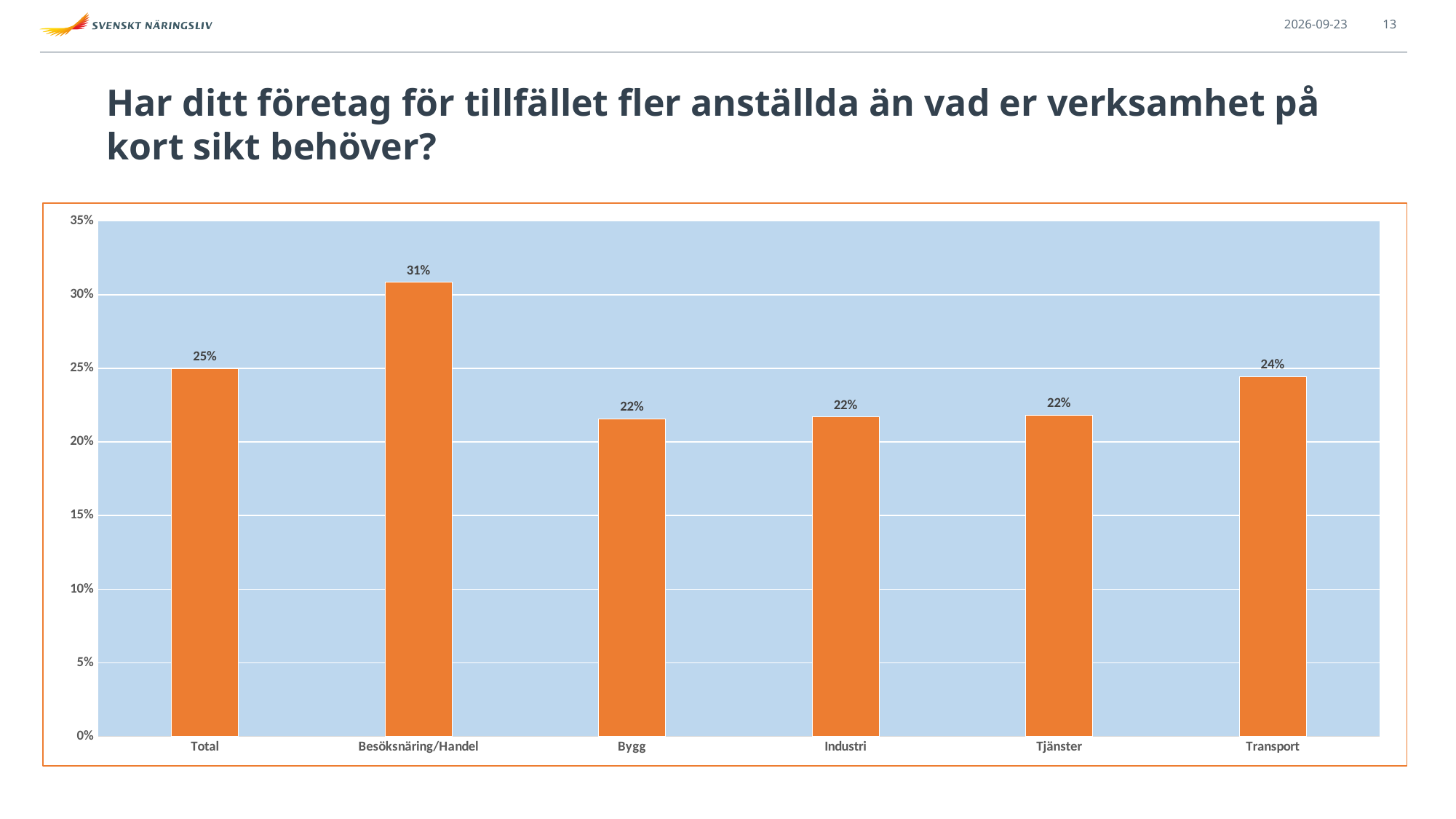
Is the value for Besöksnäring/Handel greater or less than 30%? greater What is the value for Industri? 22% Is the value for Bygg greater or less than 25%? less What is the difference between the values for Transport and Bygg? 2 percentage points Which is larger, the value for Besöksnäring/Handel or the value for Tjänster? Besöksnäring/Handel What is the value for Besöksnäring/Handel? 31% What is the value for Transport? 24% What is the difference between the values for Besöksnäring/Handel and Total? 6 percentage points How many categories are shown on the x axis? 6 What kind of chart is shown on the slide? bar chart Which category has the highest value? Besöksnäring/Handel What is the value for Total? 25%